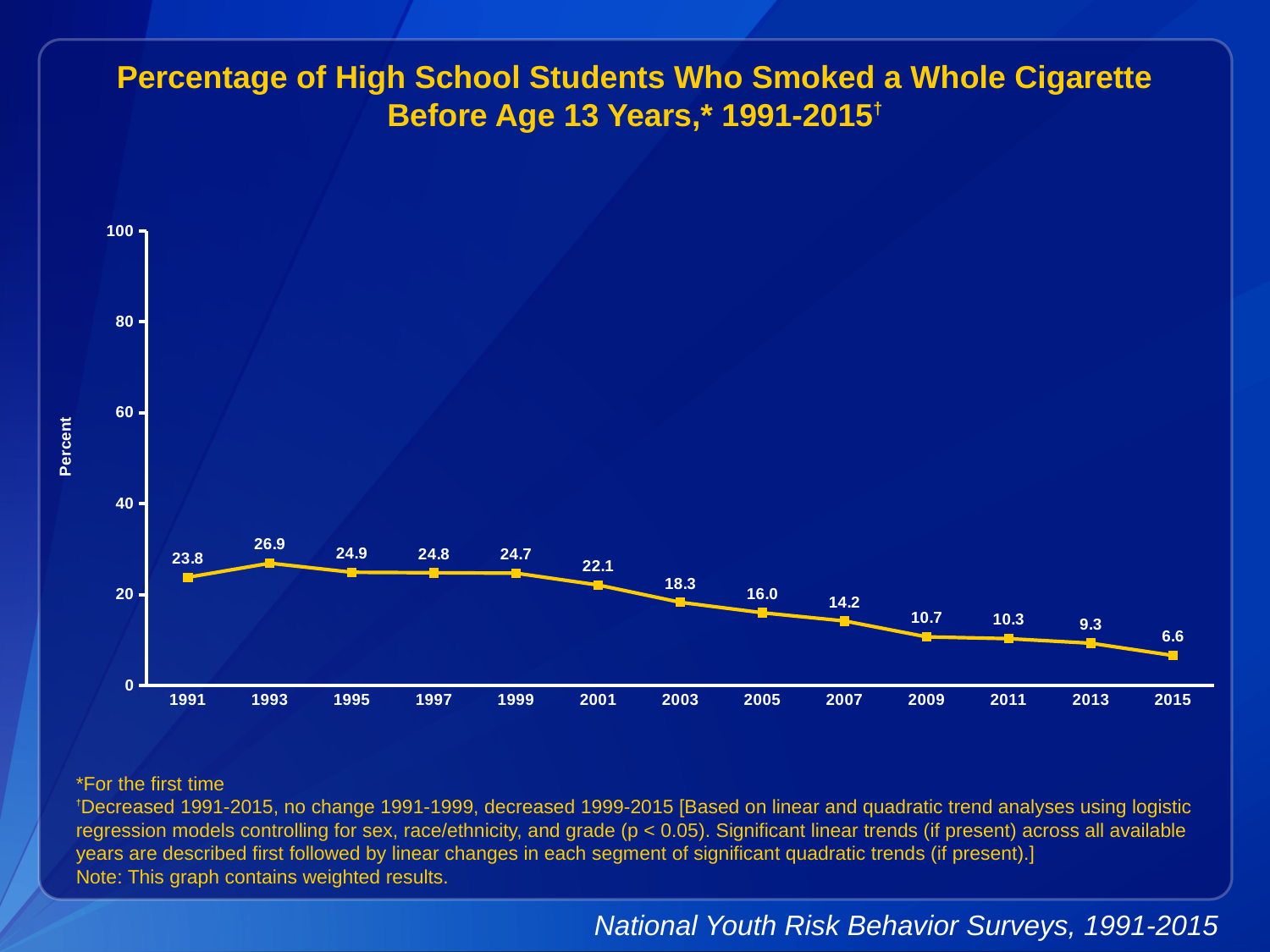
Is the value for 2009 greater or less than 20? less What is the difference between the values for 1993 and 2015? 20.3 What is the value for 1991? 23.8 What kind of chart is shown on the slide? line chart What is the value for 2003? 18.3 Do the values generally rise or fall from 1999 to 2015? fall Which year has the lowest value? 2015 Which year has the highest value? 1993 How many years are plotted on the chart? 13 What is the label on the y axis? Percent What is the value for 2015? 6.6 Which is larger, the value for 2001 or the value for 2007? 2001